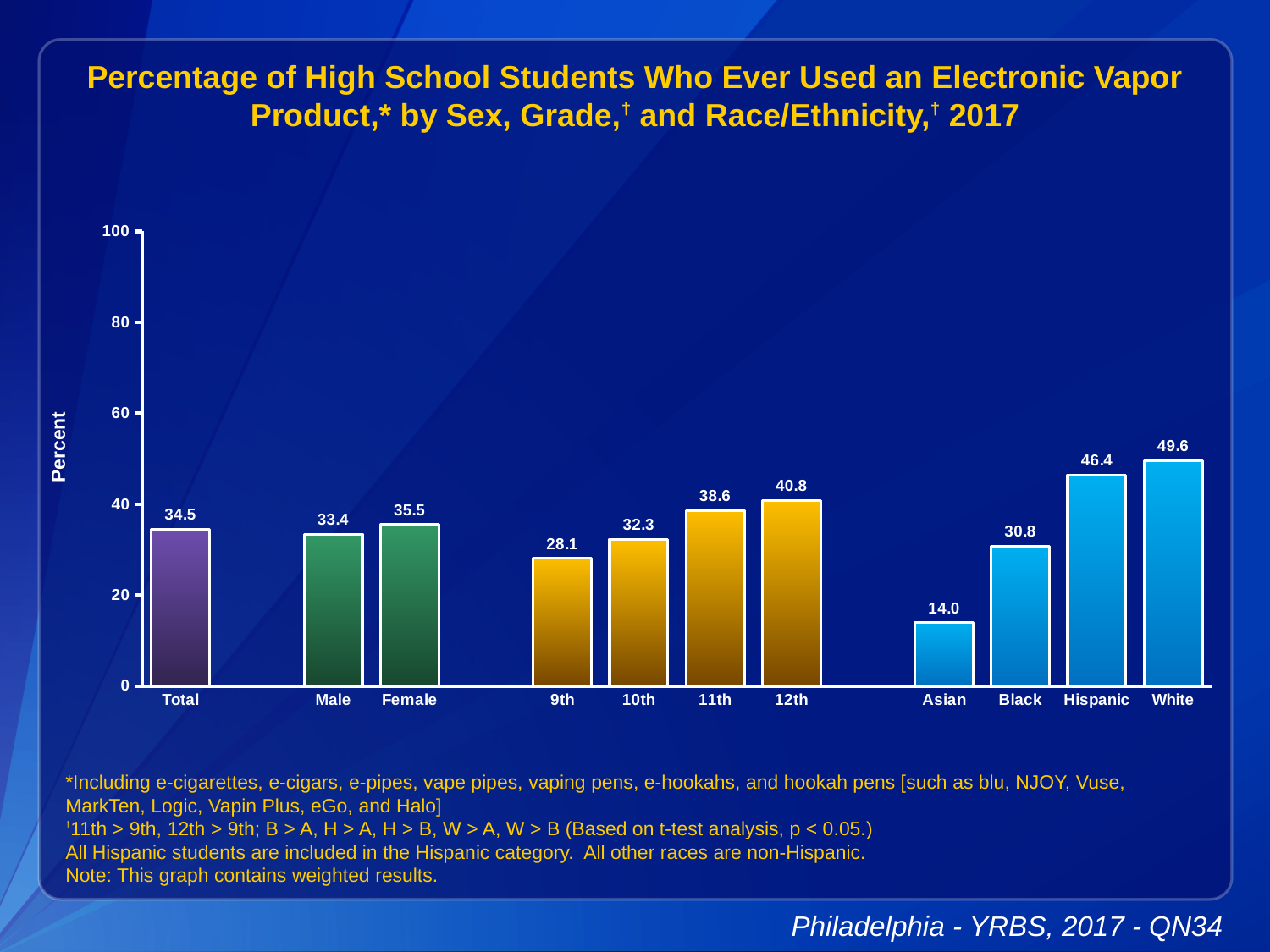
Which category has the lowest value? Asian How many categories are shown on the x axis? 11 What is the value for 12th grade? 40.8 Which category has the highest value? White What is the difference between the values for 12th and 9th grade? 12.7 What is the value for Female? 35.5 Do the values rise or fall from 9th grade to 12th grade? Rise What is the value for Asian? 14.0 What kind of chart is this? Bar chart Which is larger, the value for Hispanic or the value for Black? Hispanic What is the value for Total? 34.5 What is the difference between the values for Female and Male? 2.1